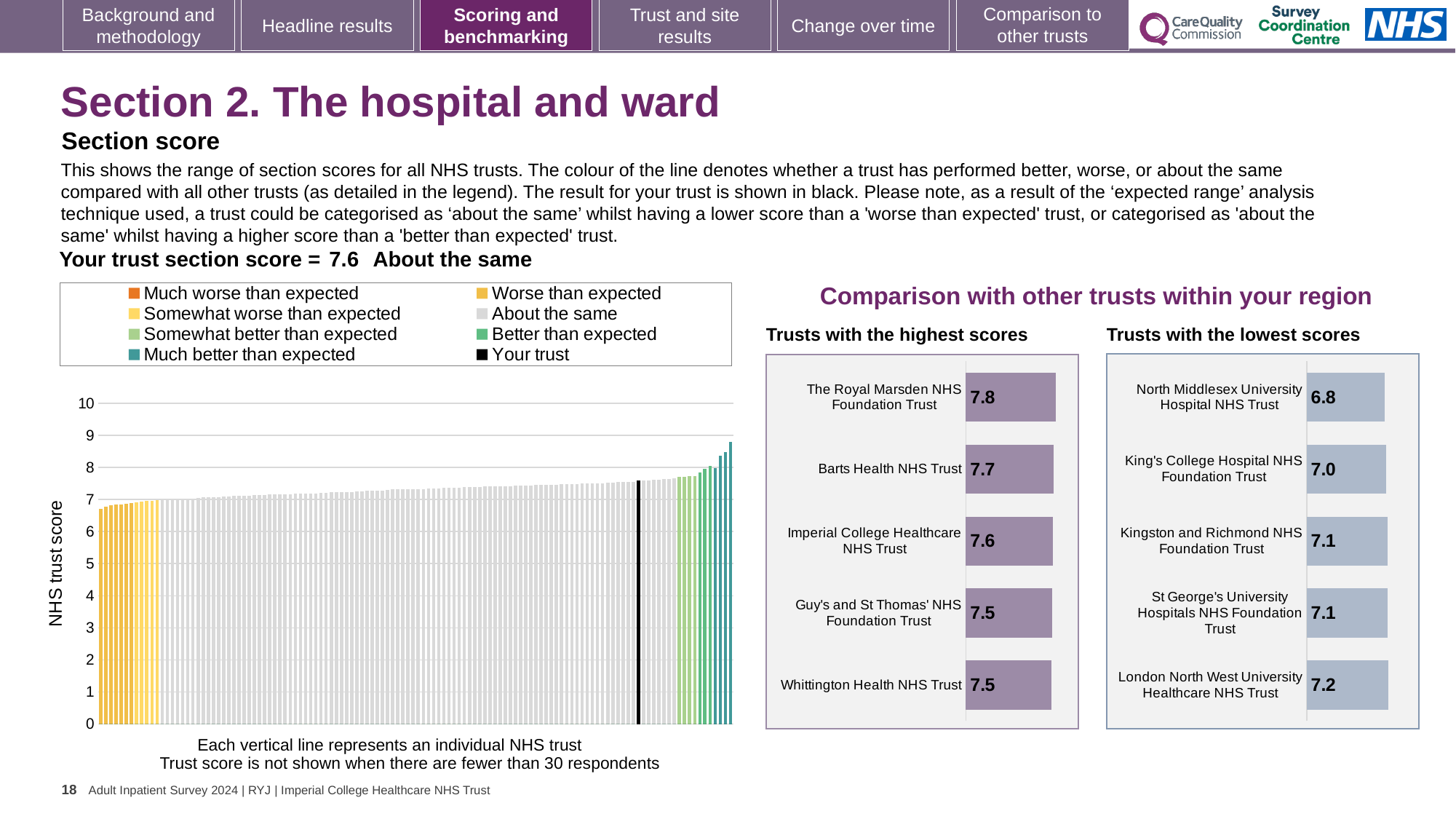
In the large chart on the left, is the value of the black 'Your trust' bar greater or less than 7? greater In the 'Trusts with the lowest scores' chart, which has the higher score: King's College Hospital NHS Foundation Trust or London North West University Healthcare NHS Trust? London North West University Healthcare NHS Trust In the 'Trusts with the lowest scores' chart, which trust has the lowest score? North Middlesex University Hospital NHS Trust How many entries does the legend of the large chart on the left list? 8 How many trusts are shown in the 'Trusts with the highest scores' chart? 5 In the 'Trusts with the highest scores' chart, what is the score for The Royal Marsden NHS Foundation Trust? 7.8 In the 'Trusts with the highest scores' chart, which trust has the highest score? The Royal Marsden NHS Foundation Trust What kind of chart is the large chart on the left showing NHS trust scores? Bar chart In the large chart on the left, do the trust scores rise or fall from left to right along the x axis? Rise In the 'Trusts with the lowest scores' chart, what is the score for London North West University Healthcare NHS Trust? 7.2 In the 'Trusts with the lowest scores' chart, what is the score for North Middlesex University Hospital NHS Trust? 6.8 In the 'Trusts with the highest scores' chart, what is the difference between the scores of The Royal Marsden NHS Foundation Trust and Whittington Health NHS Trust? 0.3